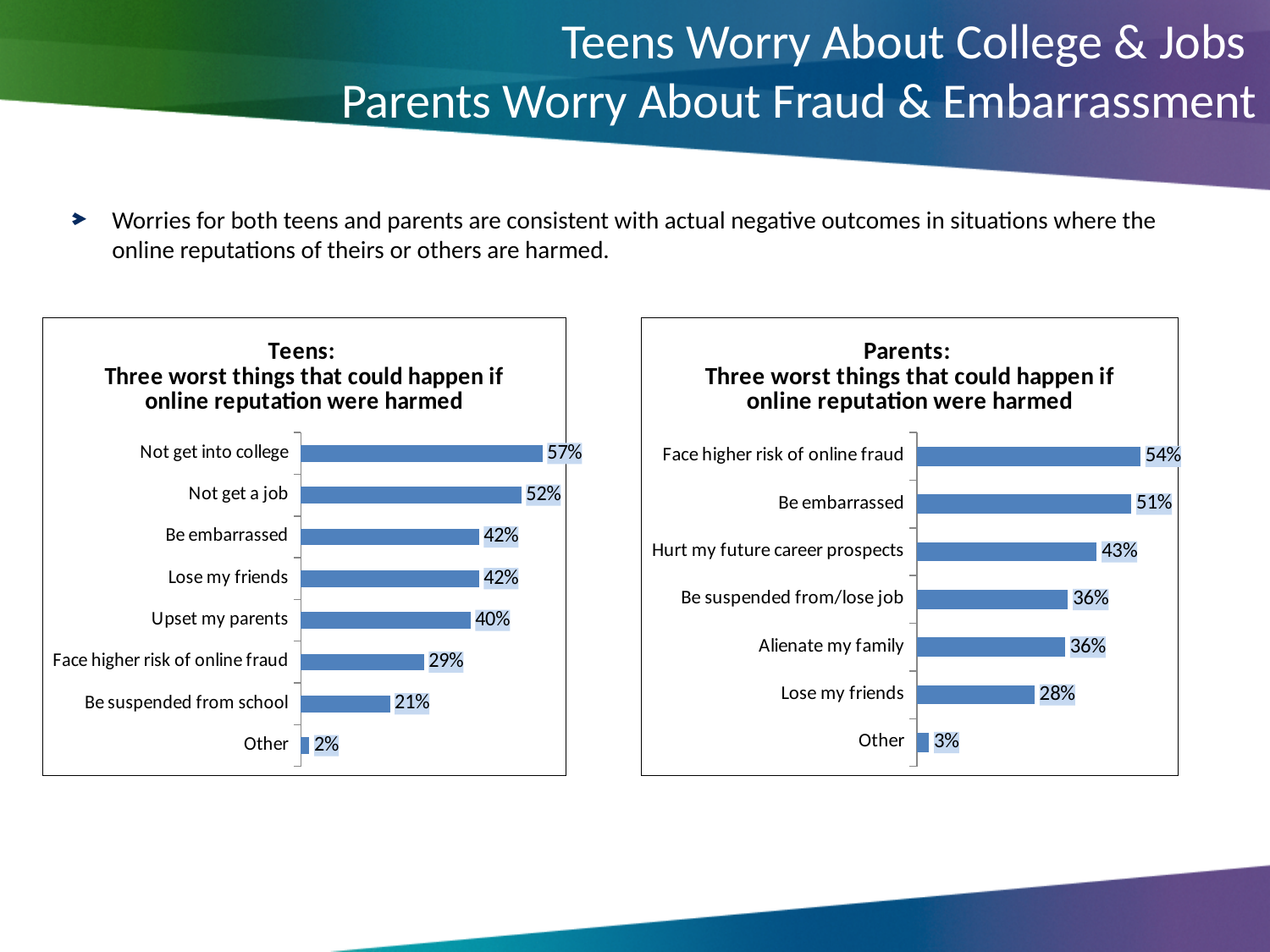
In the Parents chart, what percentage of parents said 'Hurt my future career prospects'? 43% In the Parents chart, which category has the lowest value? Other In the Teens chart, what is the difference between 'Not get into college' and 'Not get a job'? 5% What type of chart is the Parents chart? Bar chart In the Teens chart, which category has the highest value? Not get into college In the Parents chart, how many categories are shown? 7 In the Teens chart, how many categories are shown? 8 In the Parents chart, what percentage of parents said 'Be embarrassed'? 51% In the Teens chart, what is the value for 'Be suspended from school'? 21% In the Parents chart, what is the difference between 'Face higher risk of online fraud' and 'Lose my friends'? 26% In the Teens chart, what percentage of teens said 'Not get into college'? 57% Which is larger: 'Face higher risk of online fraud' in the Teens chart or 'Face higher risk of online fraud' in the Parents chart? Parents chart (54%)